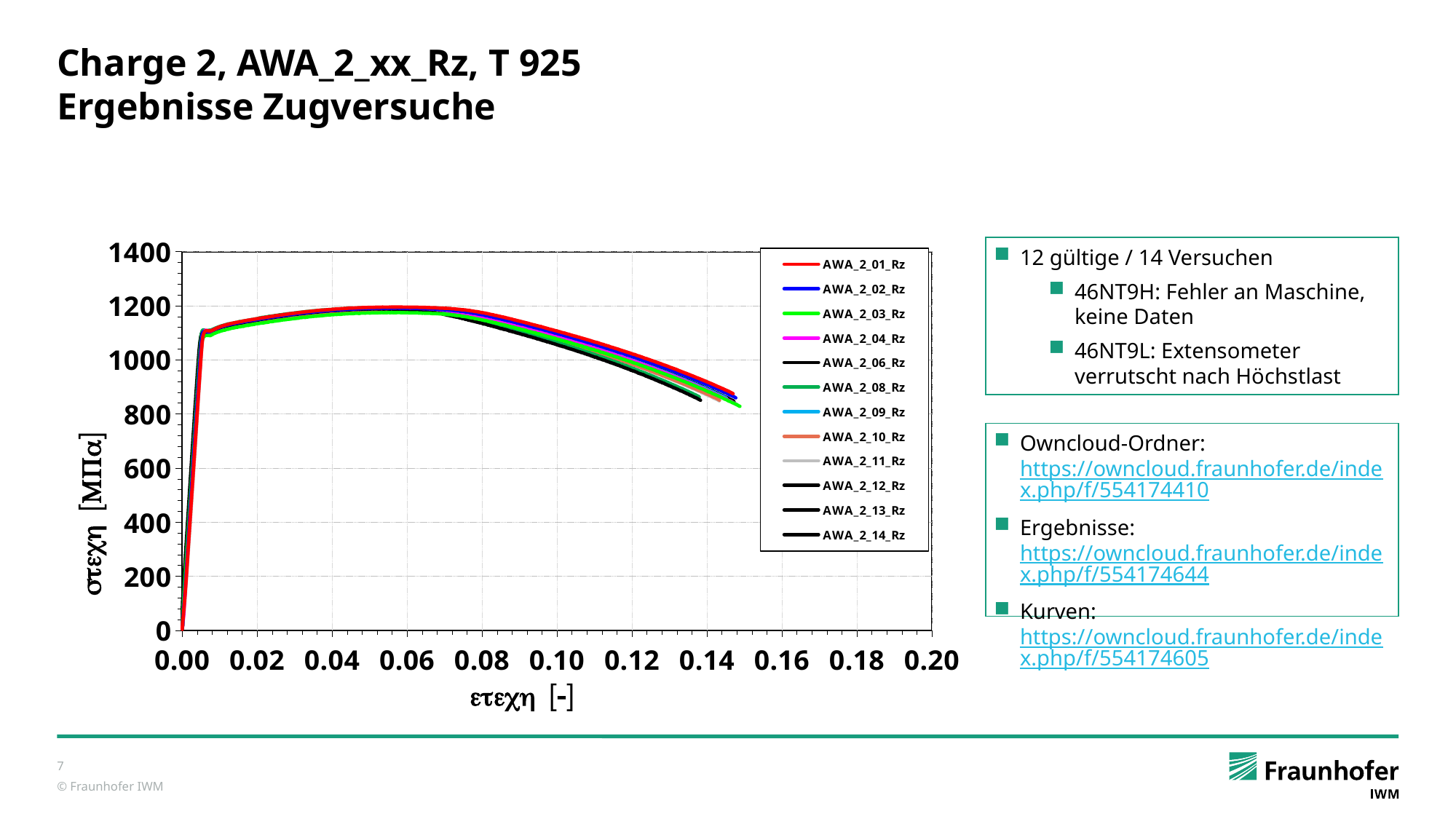
What kind of chart is shown on the slide? line chart At a strain of 0.14, is the stress of the red AWA_2_01_Rz curve greater or less than 1000 MPa? less Between strain 0.00 and 0.02, do the stress curves rise or fall? rise At a strain of 0.02, is the stress of the curves greater or less than 1000 MPa? greater How many series does the chart legend list? 12 Is the peak stress reached by the curves greater or less than 1000 MPa? greater Between strain 0.08 and 0.14, do the stress curves rise or fall? fall What colour is the AWA_2_01_Rz curve in the chart? red What is the first series listed in the chart legend? AWA_2_01_Rz